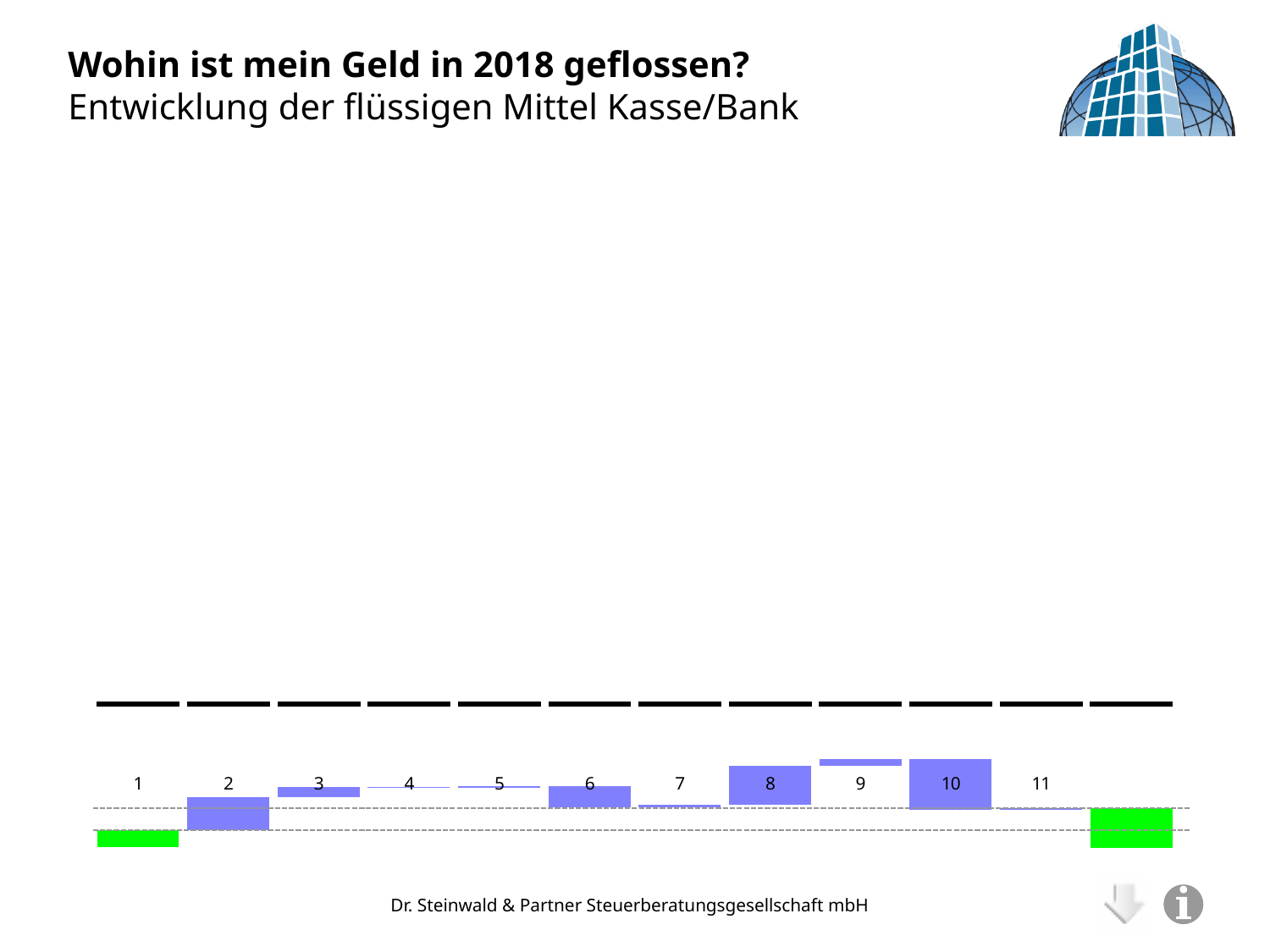
What is the subtitle of the slide describing the chart? Entwicklung der flüssigen Mittel Kasse/Bank Which bar is taller, the one for category 2 or the one for category 3? 2 What colour are the first and last bars of the chart? green What kind of chart is shown on the slide? bar chart Which numbered category has the tallest bar? 10 How many numbered categories are labelled along the chart? 11 Which bar is taller, the one for category 6 or the one for category 7? 6 Which bar is taller, the one for category 10 or the one for category 8? 10